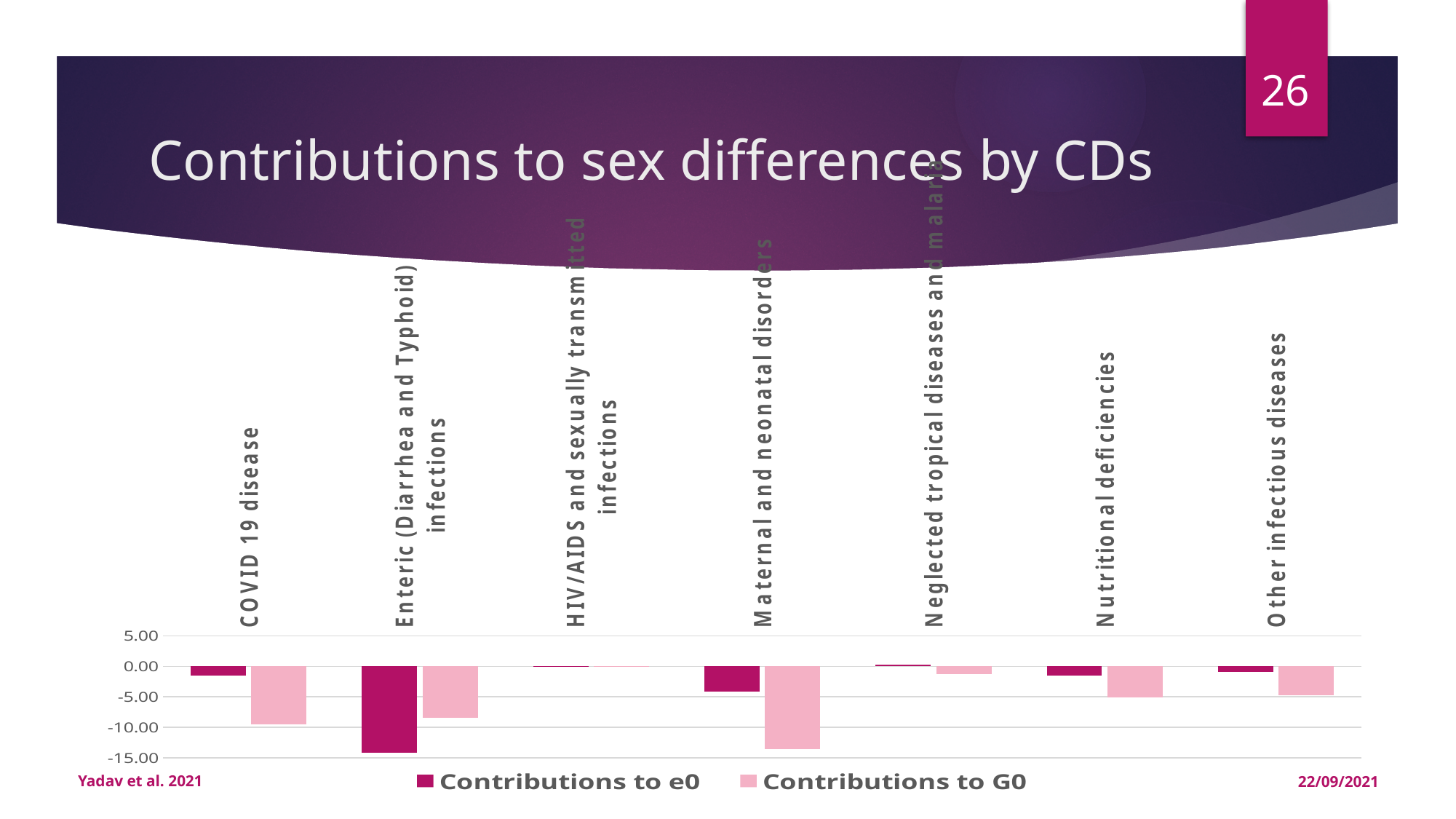
Which category has the lowest value for Contributions to e0? Enteric (Diarrhea and Typhoid) infections Is the Contributions to G0 value for Maternal and neonatal disorders greater or less than -10.00? less How many disease categories are shown on the x axis of the chart? 7 What is the title of the chart on the slide? Contributions to sex differences by CDs Which category has the lowest value for Contributions to G0? Maternal and neonatal disorders What are the two series named in the chart legend? Contributions to e0 and Contributions to G0 Is the Contributions to G0 value for COVID 19 disease greater or less than -5.00? less What kind of chart is shown on the slide? bar chart Is the Contributions to e0 value for Nutritional deficiencies greater or less than -5.00? greater Which has the larger (less negative) Contributions to e0 value: COVID 19 disease or Maternal and neonatal disorders? COVID 19 disease How many series does the chart legend list? 2